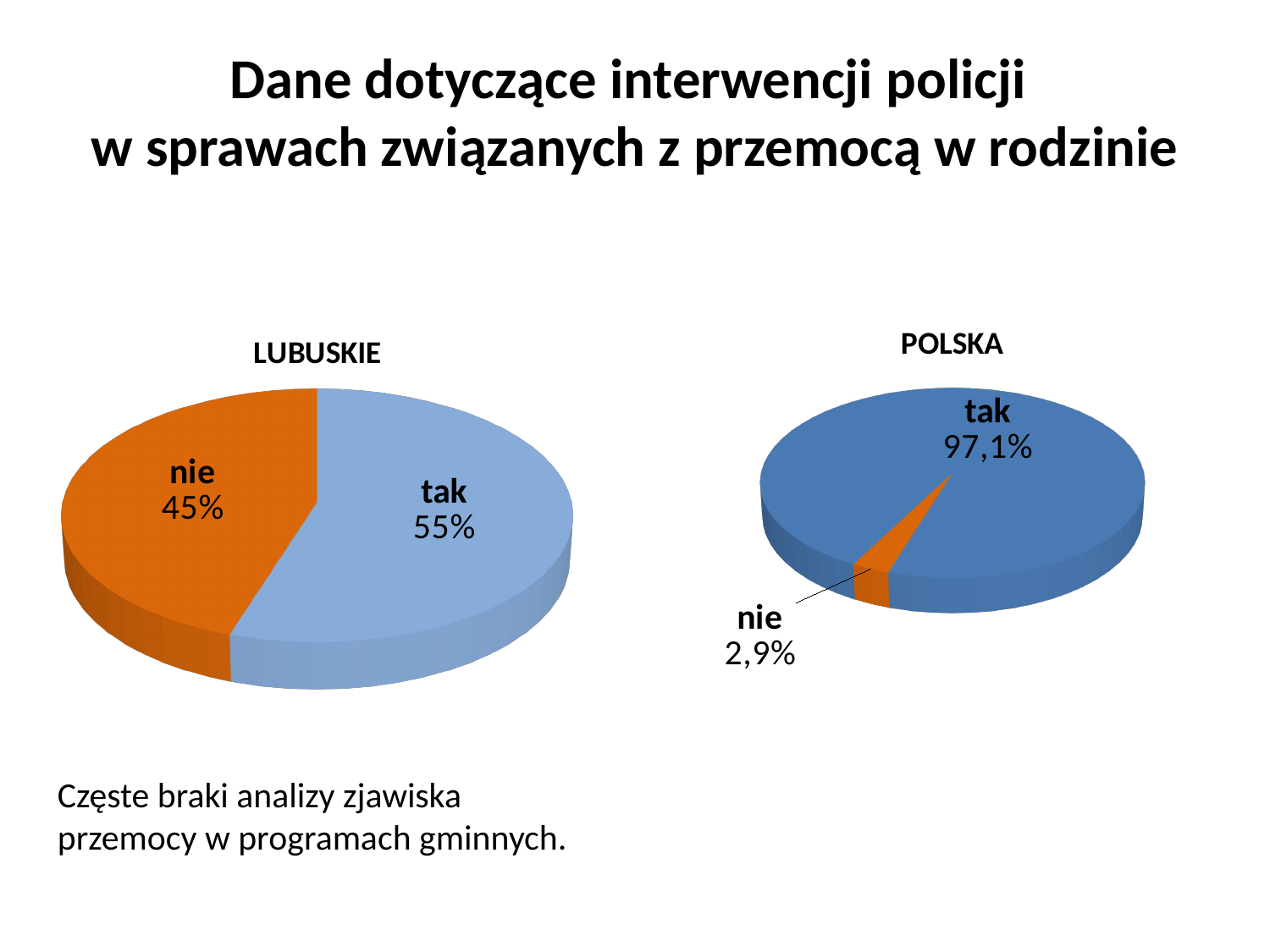
In the LUBUSKIE chart, what is the difference between the "tak" and "nie" shares? 10% How many slices does the POLSKA chart have? 2 In the POLSKA chart, which slice is the smallest? nie In the POLSKA chart, what share does the "nie" slice have? 2,9% In the LUBUSKIE chart, what share does the "nie" slice have? 45% What is the title of the chart on the right side of the slide? POLSKA In the LUBUSKIE chart, which slice is the largest? tak In the LUBUSKIE chart, what share does the "tak" slice have? 55% In the POLSKA chart, what is the difference between the "tak" and "nie" shares? 94,2% In the POLSKA chart, what share does the "tak" slice have? 97,1% What type of chart is the LUBUSKIE chart? Pie chart Which chart has the larger "nie" share, LUBUSKIE or POLSKA? LUBUSKIE